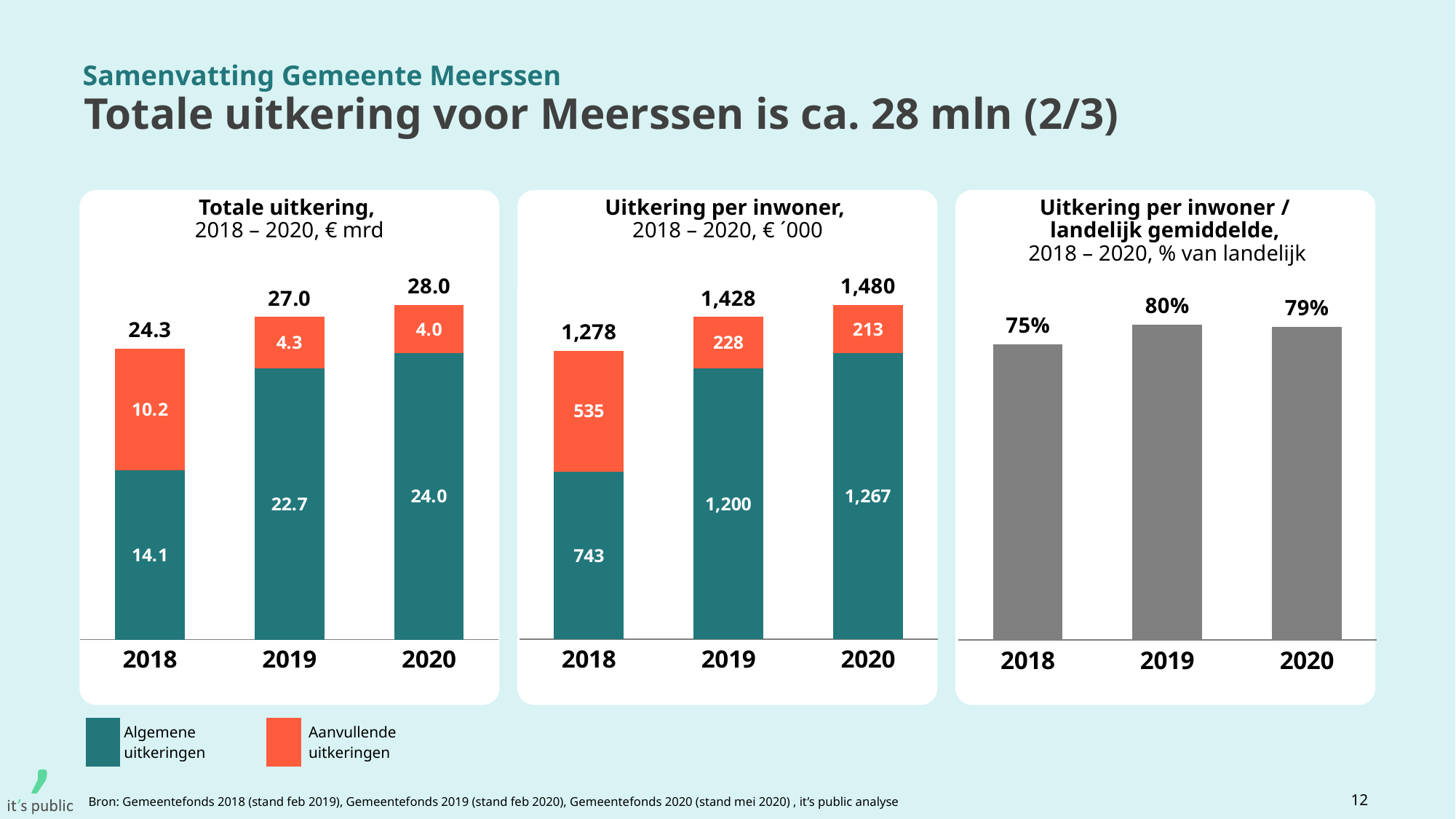
In the 'Uitkering per inwoner / landelijk gemiddelde' chart, what is the value for 2018? 75% In the 'Totale uitkering' chart, what is the value of Aanvullende uitkeringen for 2018? 10.2 In the 'Totale uitkering' chart, is the Aanvullende uitkeringen value larger in 2019 or 2020? 2019 How many series does the legend list for the stacked bar charts? 2 What kind of chart is the 'Uitkering per inwoner / landelijk gemiddelde' chart? Bar chart In the 'Uitkering per inwoner' chart, what is the total for 2018? 1,278 In the 'Totale uitkering' chart, which year has the lowest total? 2018 In the 'Uitkering per inwoner' chart, what is the difference between the Aanvullende uitkeringen values for 2018 and 2019? 307 In the 'Totale uitkering' chart, what is the total of the stacked bar for 2020? 28.0 In the 'Totale uitkering' chart, what is the value of Algemene uitkeringen for 2019? 22.7 In the 'Uitkering per inwoner / landelijk gemiddelde' chart, which year has the highest value? 2019 In the 'Uitkering per inwoner' chart, what is the value of Algemene uitkeringen for 2020? 1,267